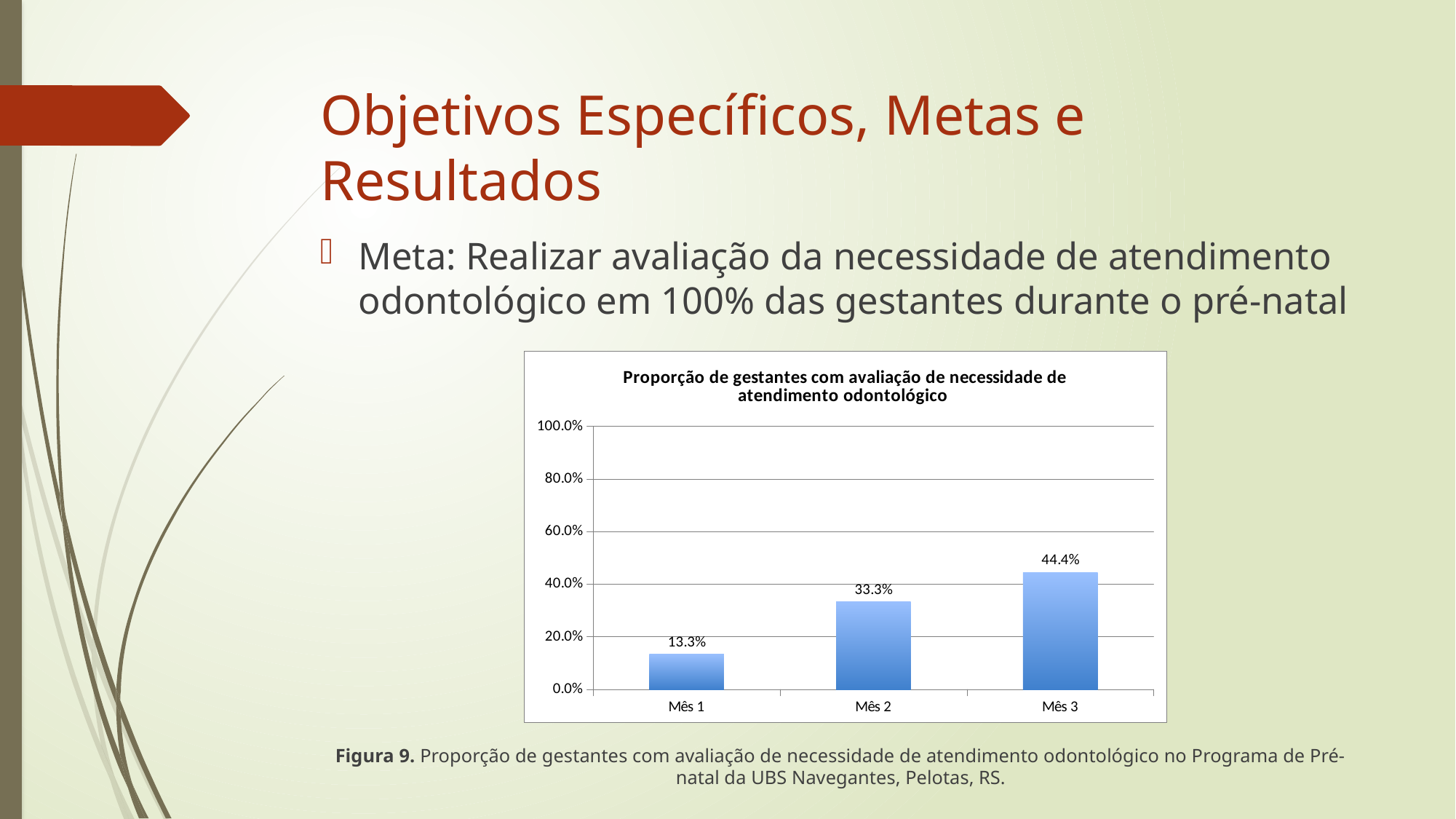
What is the value for Mês 3? 44.4% Is the value for Mês 3 greater or less than 40.0%? greater Do the values rise or fall from Mês 1 to Mês 3? Rise What is the difference between the values for Mês 2 and Mês 1? 20.0% What is the difference between the values for Mês 3 and Mês 2? 11.1% What kind of chart is shown on the slide? Bar chart What is the value for Mês 2? 33.3% What is the value for Mês 1? 13.3% Which month has the highest value? Mês 3 Which month has the lowest value? Mês 1 Which is larger, the value for Mês 1 or the value for Mês 2? Mês 2 How many months are shown on the x axis? 3